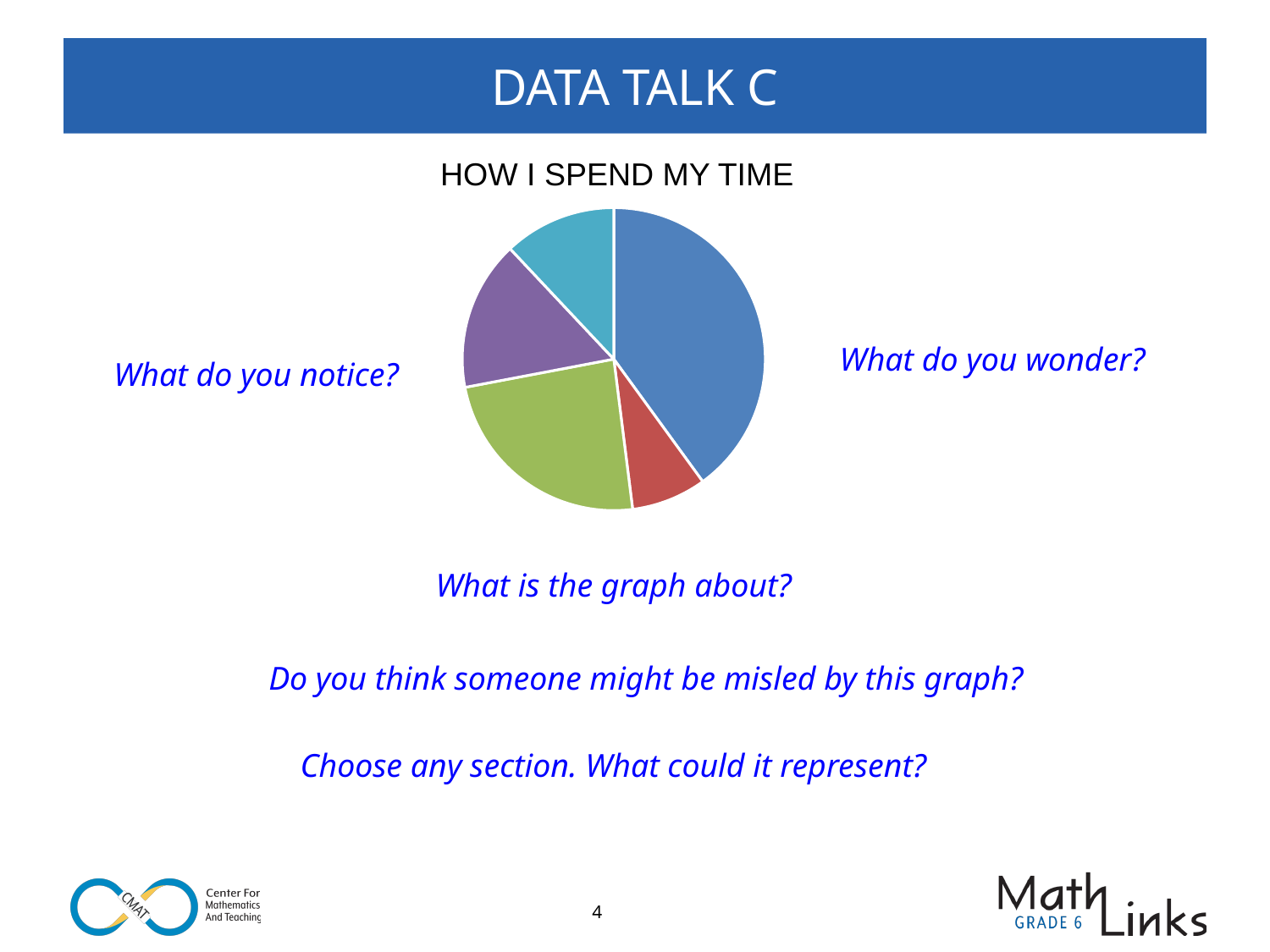
Which is larger in the pie chart, the green slice or the red slice? green Which is larger in the pie chart, the teal slice or the red slice? teal How many slices does the pie chart have? 5 What kind of chart is shown on the slide? pie chart Does the pie chart show a legend identifying the slices? no What is the title of the pie chart? HOW I SPEND MY TIME Which colour slice is the largest in the pie chart? blue Which is larger in the pie chart, the green slice or the purple slice? green Which colour slice is the smallest in the pie chart? red